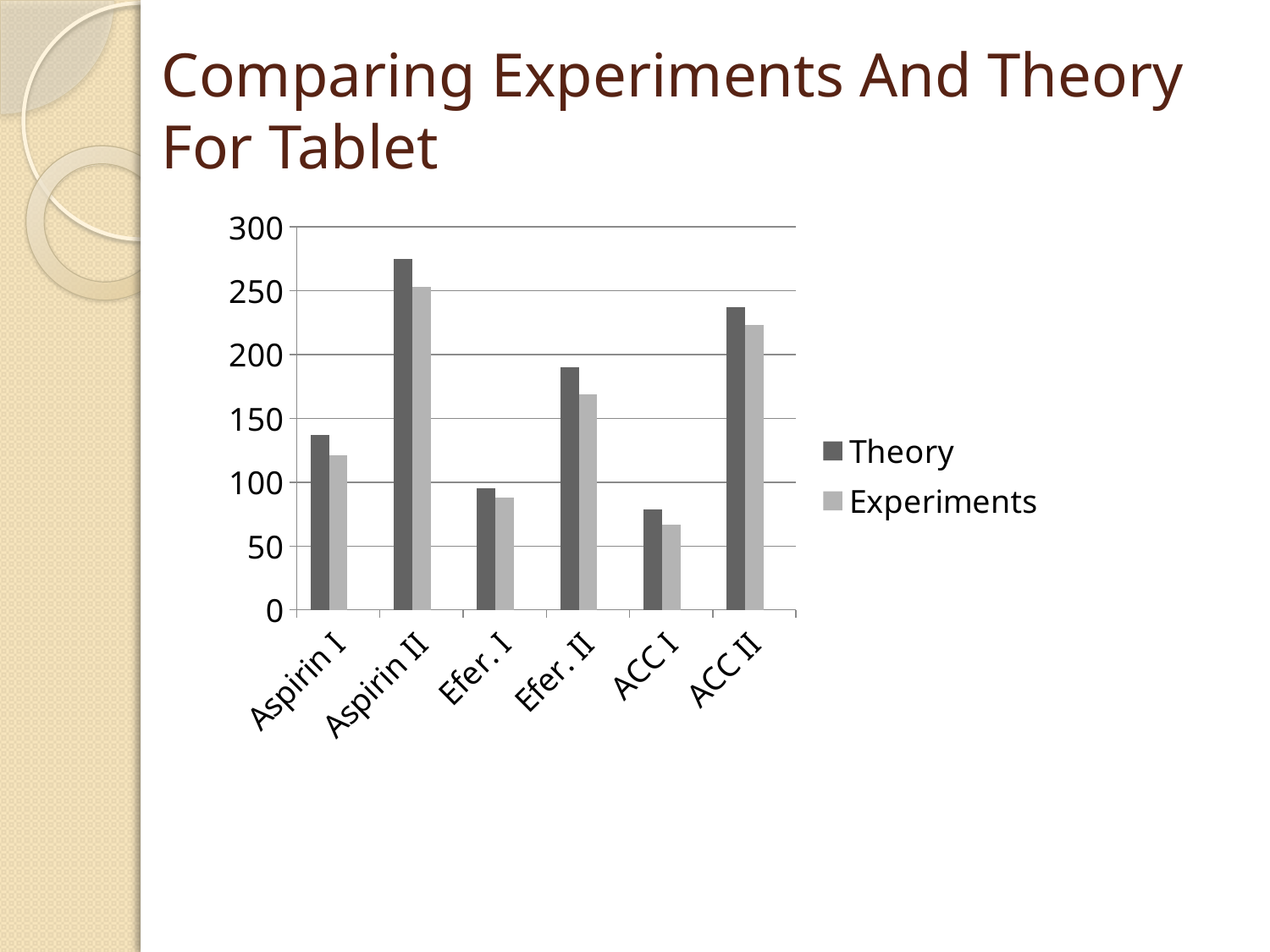
Which category has the lowest Experiments value? ACC I Which category has the highest Theory value? Aspirin II Is the Theory value for Efer. II greater or less than 150? greater Is the Theory value for Aspirin II greater or less than 250? greater Which category has the lowest Theory value? ACC I For Aspirin II, which is larger: the Theory value or the Experiments value? Theory How many series does the legend list? 2 Is the Experiments value for ACC I greater or less than 100? less What type of chart is shown on the slide? Bar chart What are the two series named in the legend? Theory and Experiments How many categories are shown on the x axis of the chart? 6